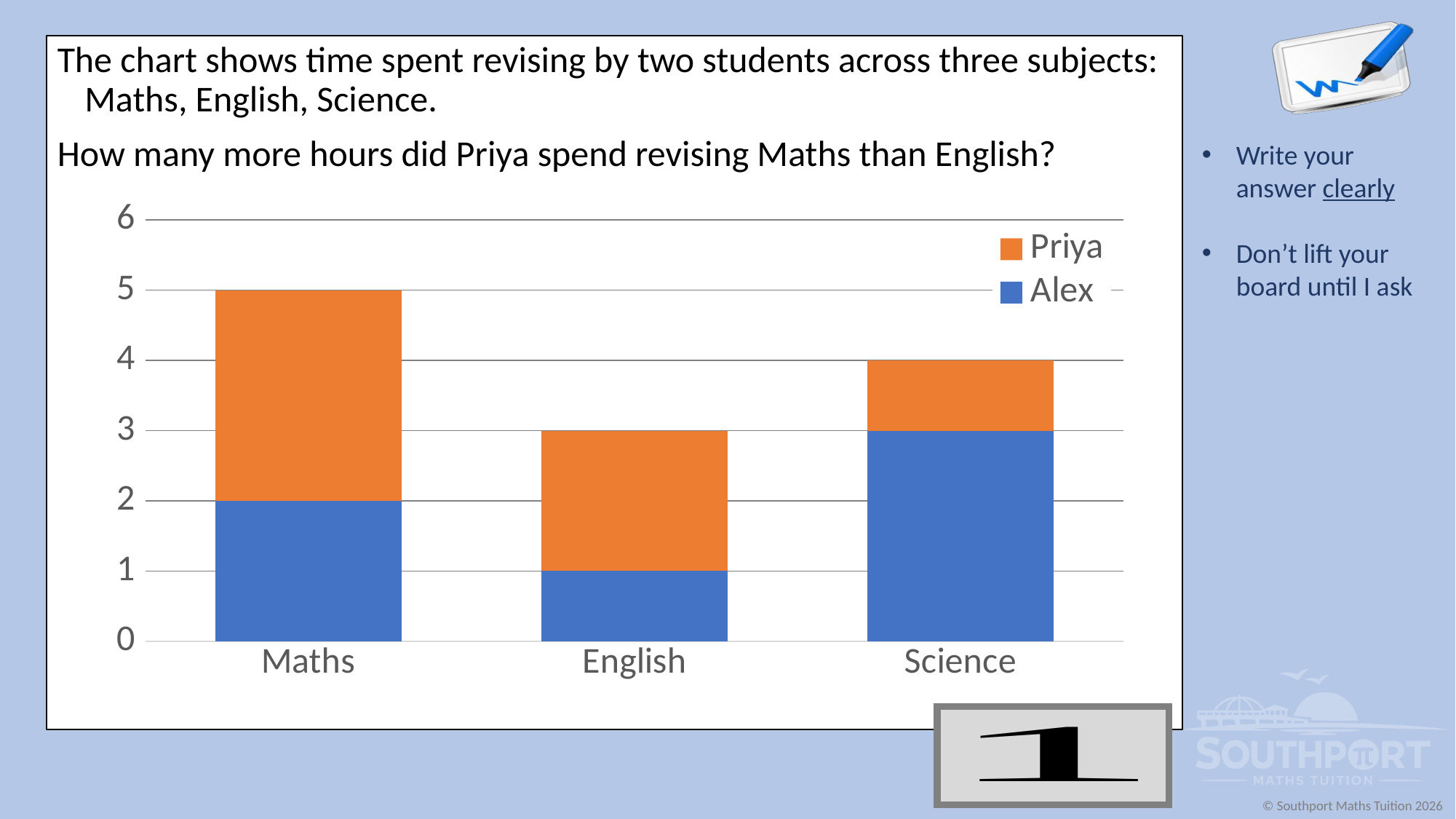
How many hours did Priya spend revising Maths? 3 How many hours did Alex spend revising English? 1 Which subject has the shortest stacked bar overall? English Which colour represents Priya in the legend? Orange How many series does the legend list? 2 Which subject has the tallest stacked bar overall? Maths What is the total height of the stacked bar for Maths? 5 What kind of chart is shown on the slide? Stacked bar chart What is the total height of the stacked bar for Science? 4 How many hours did Alex spend revising Science? 3 How many subjects are shown on the x axis? 3 What is the total height of the stacked bar for English? 3